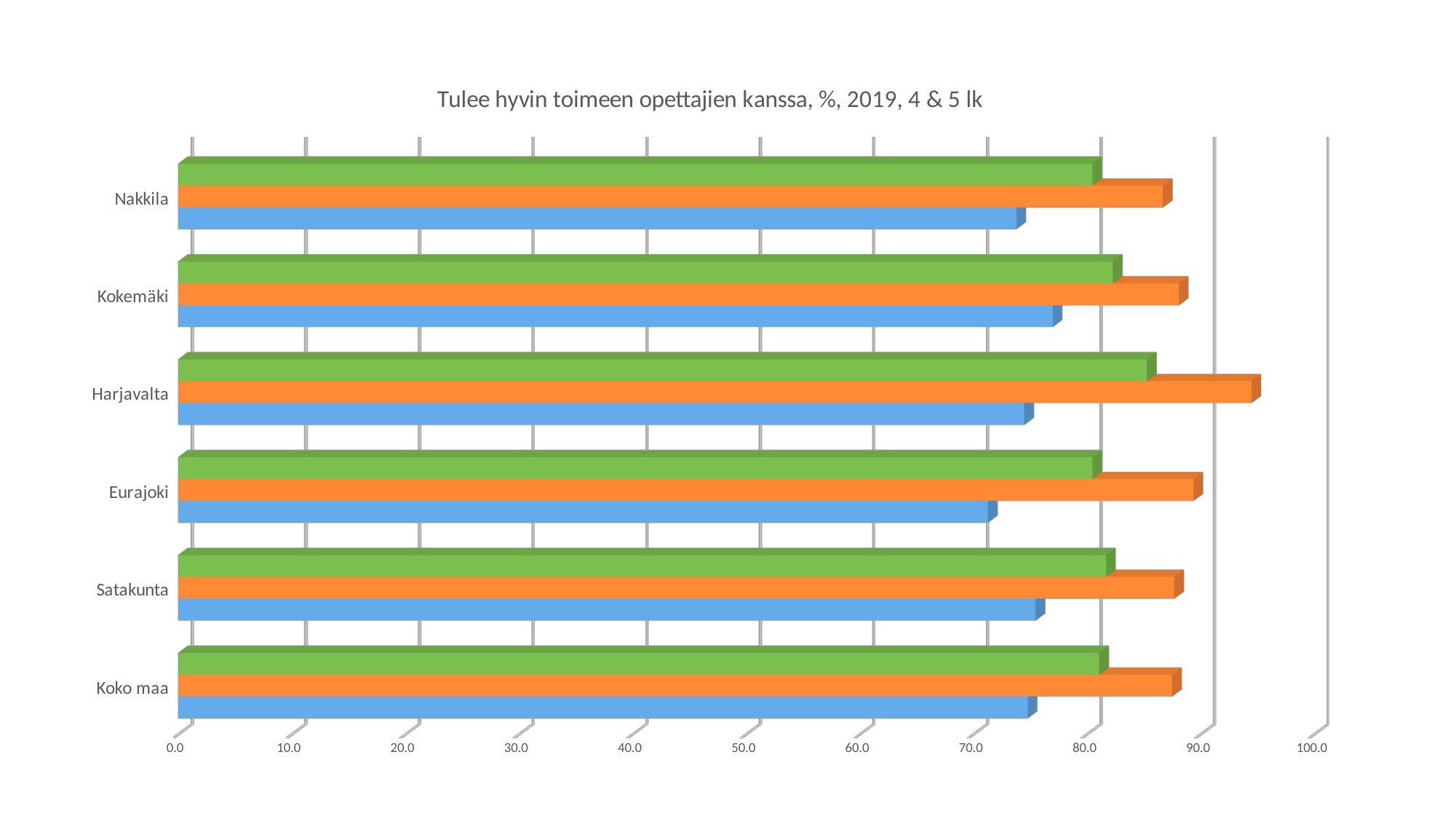
What is the title of the chart? Tulee hyvin toimeen opettajien kanssa, %, 2019, 4 & 5 lk How many bars are shown for each category in the chart? 3 Which is longer, the green bar for Harjavalta or the green bar for Nakkila? Harjavalta Is the blue bar for Eurajoki greater or less than 80? less For Harjavalta, which bar is longer, the orange bar or the green bar? orange Which category has the longest orange bar? Harjavalta What kind of chart is shown on the slide? bar chart Is the orange bar for Kokemäki greater or less than 90? less How many categories are listed on the vertical axis of the chart? 6 In every category, which colour of bar is the longest? orange Is the green bar for Nakkila greater or less than 70? greater